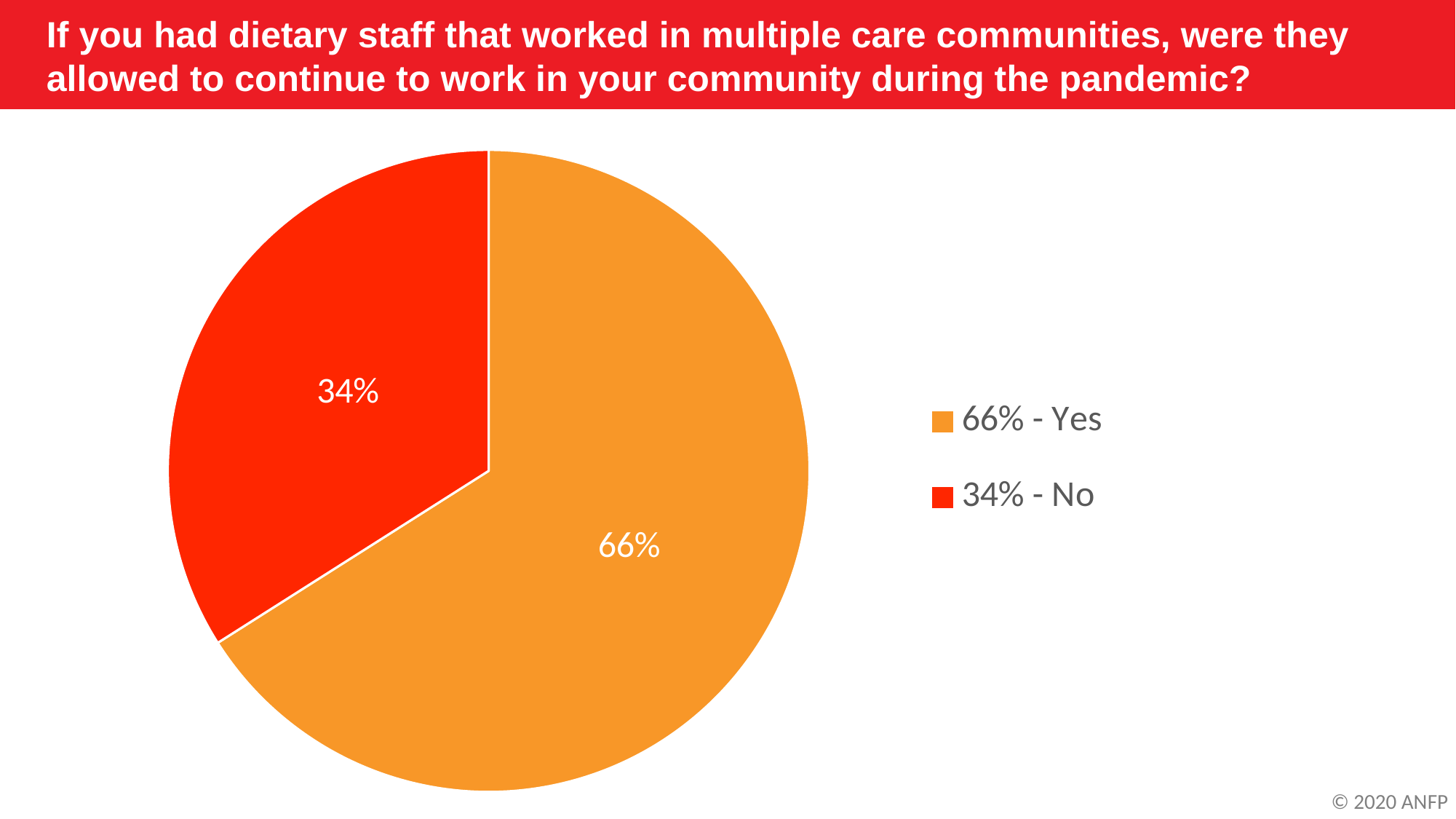
Which response has the smallest share of the pie? No How many slices does the pie chart have? 2 What kind of chart is shown on the slide? pie chart What percentage of respondents answered No? 34% What share of the pie does the No slice represent? 34% Which response has the largest share of the pie? Yes What colour is the No slice of the pie? red Which response is larger, Yes or No? Yes How many entries does the legend list? 2 What colour is the Yes slice of the pie? orange What percentage of respondents answered Yes? 66% What is the difference in percentage points between the Yes and No responses? 32